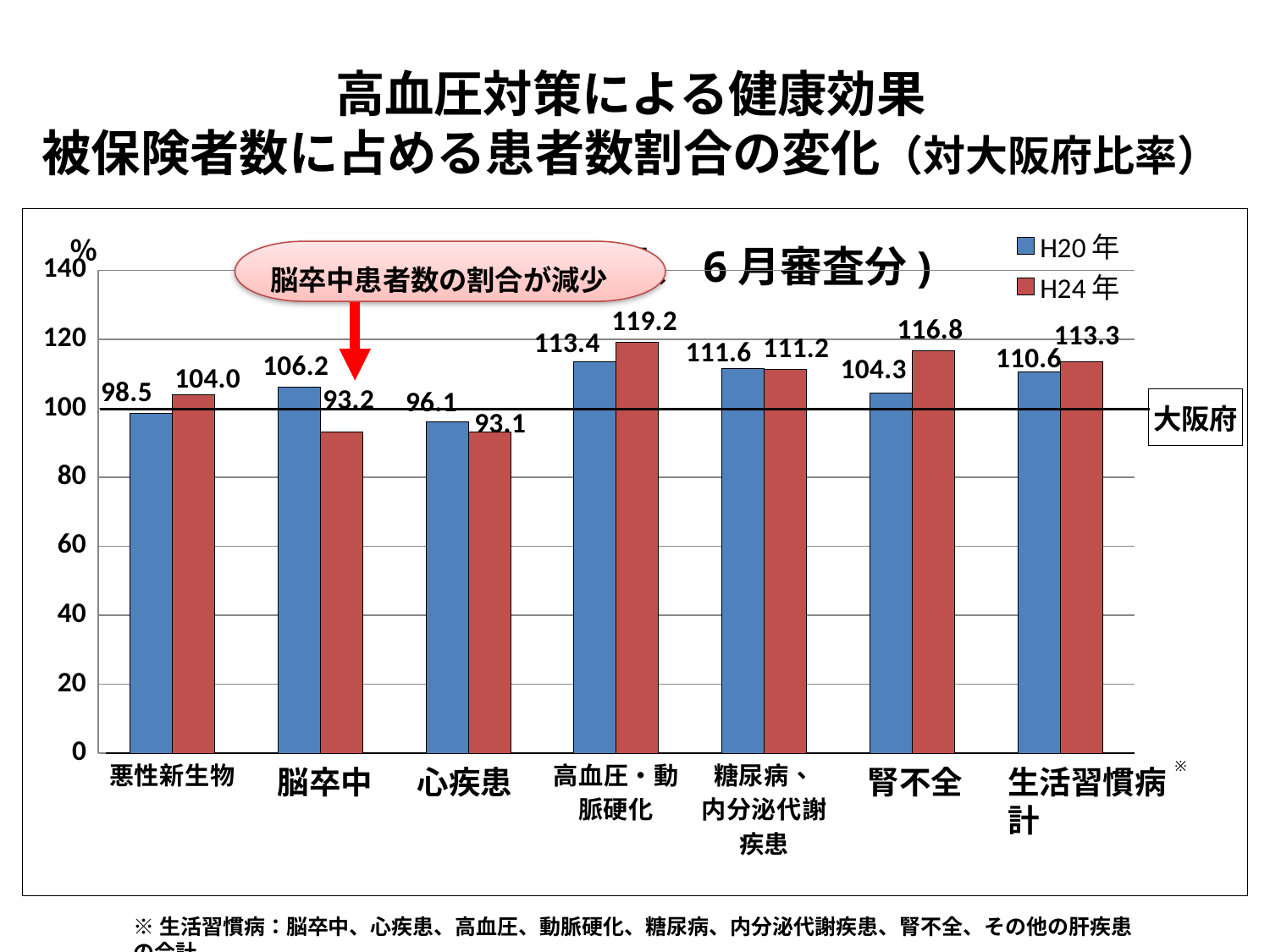
What is the H24年 value for 脳卒中? 93.2 What label is attached to the horizontal reference line at 100? 大阪府 What is the H20年 value for 高血圧・動脈硬化? 113.4 Which category has the highest H24年 value? 高血圧・動脈硬化 What is the difference between the H24年 and H20年 values for 腎不全? 12.5 How many series does the legend list? 2 How many categories are shown on the x axis? 7 What is the H24年 value for 腎不全? 116.8 By how much did the value for 脳卒中 fall from H20年 to H24年? 13.0 Which category has the lowest H20年 value? 心疾患 For 悪性新生物, which is larger, the H20年 value or the H24年 value? H24年 Is the H24年 value for 心疾患 greater or less than 100? less